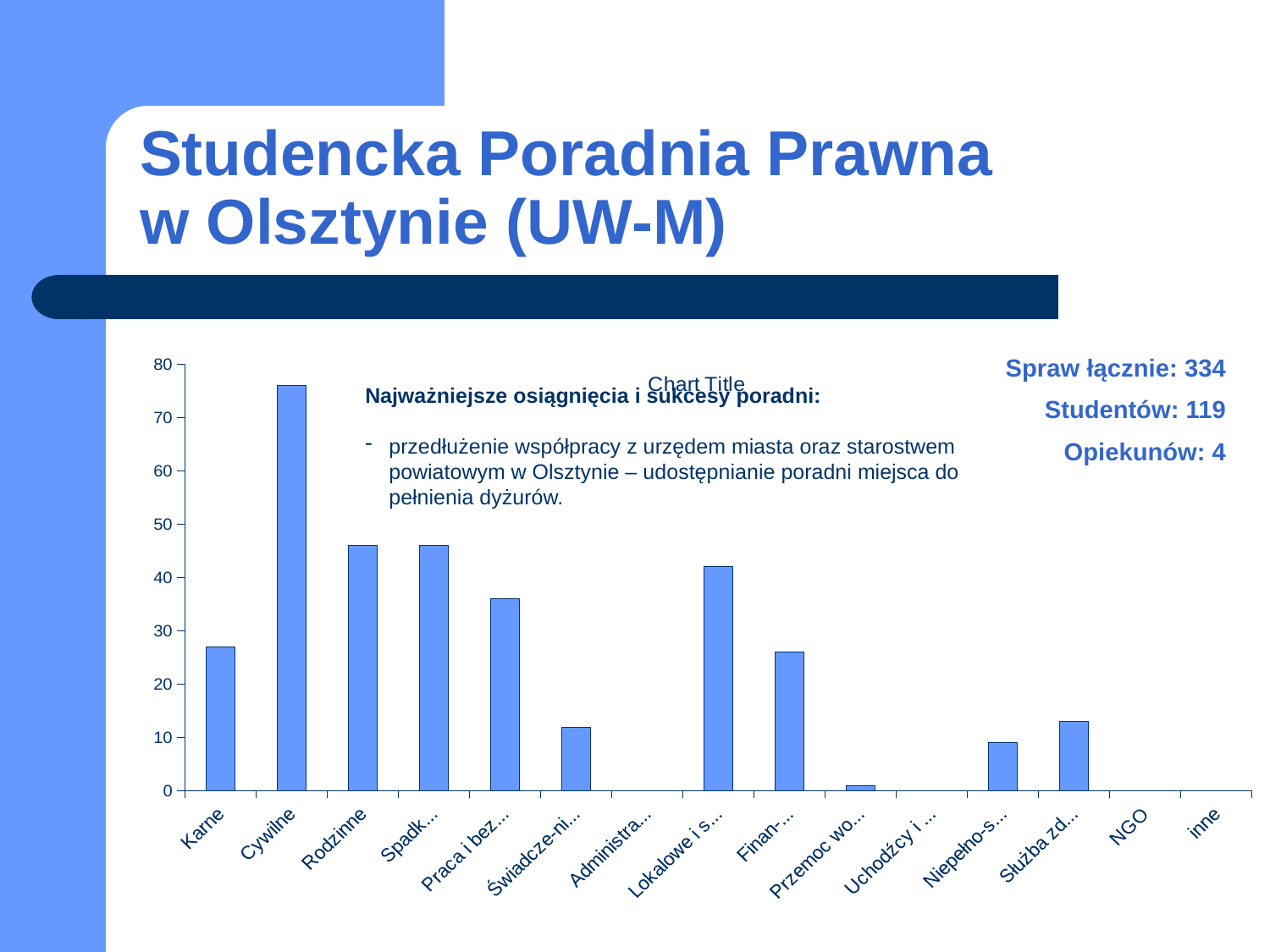
How many categories are shown along the x axis of the chart? 15 Is the value for Świadcze-ni... greater or less than 20? less Which is larger, the value for Lokalowe i s... or the value for Finan-...? Lokalowe i s... Is the value for Karne greater or less than 30? less Is the value for Lokalowe i s... greater or less than 40? greater Which is larger, the value for Cywilne or the value for Karne? Cywilne What is the title shown on the chart? Chart Title What kind of chart is shown on the slide? bar chart Which category has the highest bar in the chart? Cywilne Which is larger, the value for Praca i bez... or the value for Służba zd...? Praca i bez...